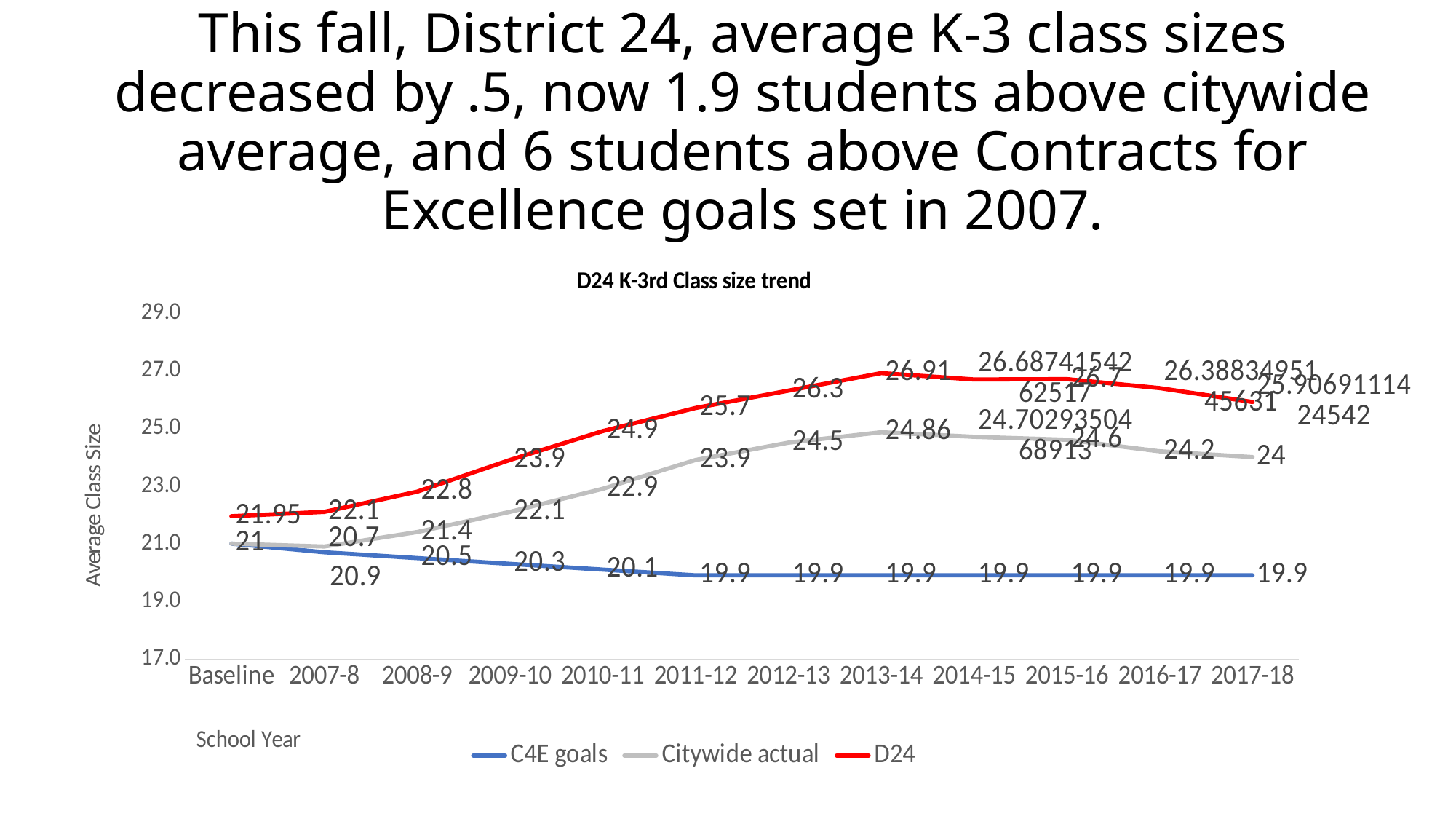
What is the Citywide actual value for 2013-14? 24.86 Which is larger in 2010-11, the D24 value or the Citywide actual value? D24 What is the D24 value at Baseline? 21.95 Is the Citywide actual value for 2017-18 greater or less than 25.0? less What kind of chart is shown on the slide? line chart What colour is the D24 line in the legend? red What is the C4E goals value for 2017-18? 19.9 What is the difference between the D24 value and the Citywide actual value in 2011-12? 1.8 How many series does the legend list? 3 How many school-year categories are shown on the x axis? 12 In which school year does the D24 series reach its highest value? 2013-14 What is the D24 value for 2013-14? 26.91